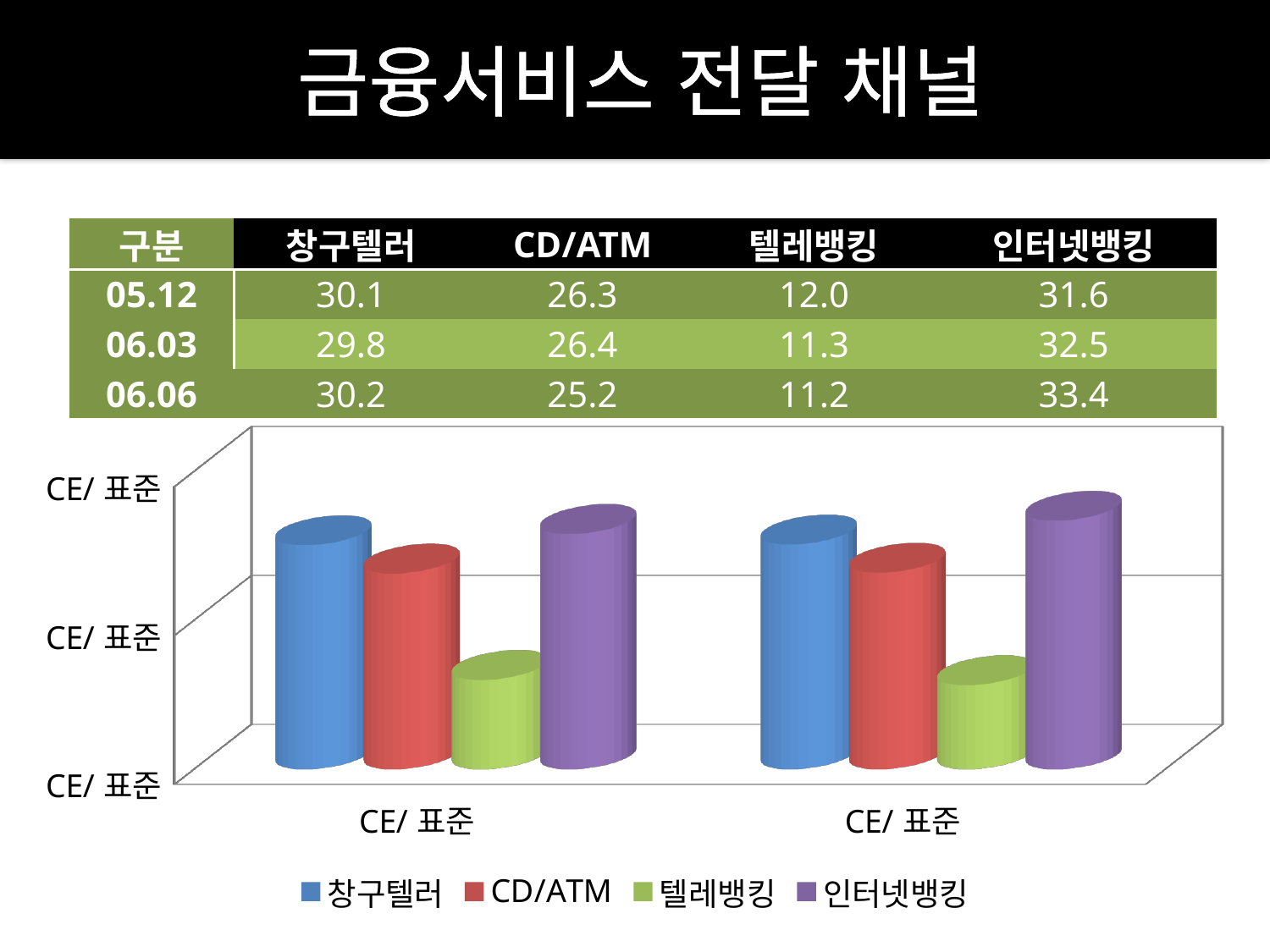
How many category groups of bars are plotted in the chart? 2 What are the series listed in the chart legend? 창구텔러, CD/ATM, 텔레뱅킹, 인터넷뱅킹 In the right group of bars, which series has the lowest bar? 텔레뱅킹 In the left group of bars, which is taller: 창구텔러 or CD/ATM? 창구텔러 How many series does the chart legend list? 4 In the left group of bars, which series has the lowest bar? 텔레뱅킹 What colour represents 텔레뱅킹 in the chart? green In the right group of bars, which series has the highest bar? 인터넷뱅킹 In the left group of bars, which is taller: 인터넷뱅킹 or 텔레뱅킹? 인터넷뱅킹 In the right group of bars, which is taller: 텔레뱅킹 or CD/ATM? CD/ATM What kind of chart is shown on the slide? bar chart